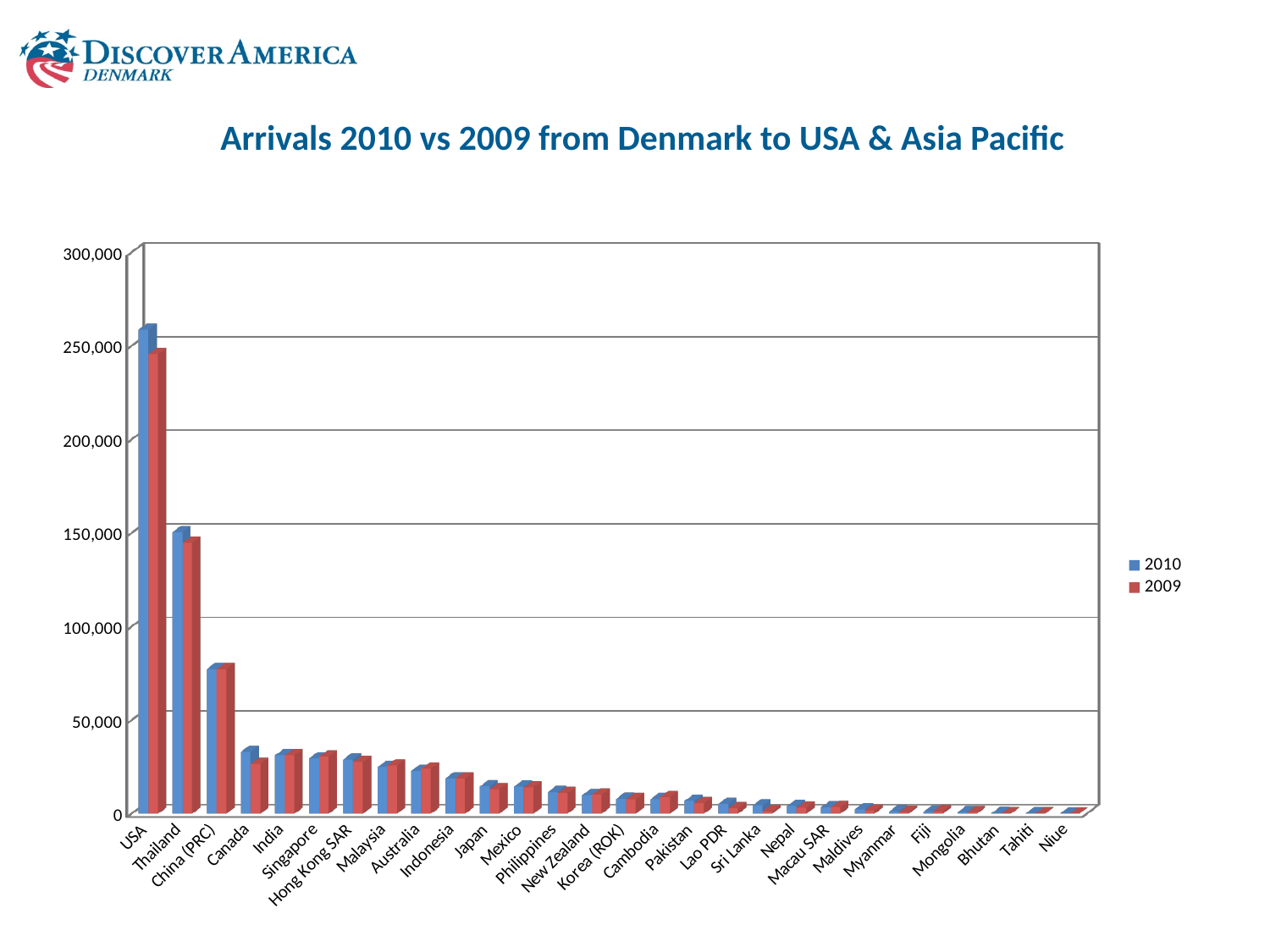
What kind of chart is shown on the slide? bar chart How many series does the legend list? 2 For Canada, which year has the larger value, 2010 or 2009? 2010 How many countries are shown on the x axis? 28 For USA, which year has the larger value, 2010 or 2009? 2010 Is the 2010 value for USA greater or less than 250,000? greater Is the 2010 value for China (PRC) greater or less than 50,000? greater Which country has the highest number of arrivals in 2010? USA What is the title of the chart? Arrivals 2010 vs 2009 from Denmark to USA & Asia Pacific Is the 2010 value for Canada greater or less than 50,000? less Do the values generally rise or fall moving from left to right along the x axis? fall